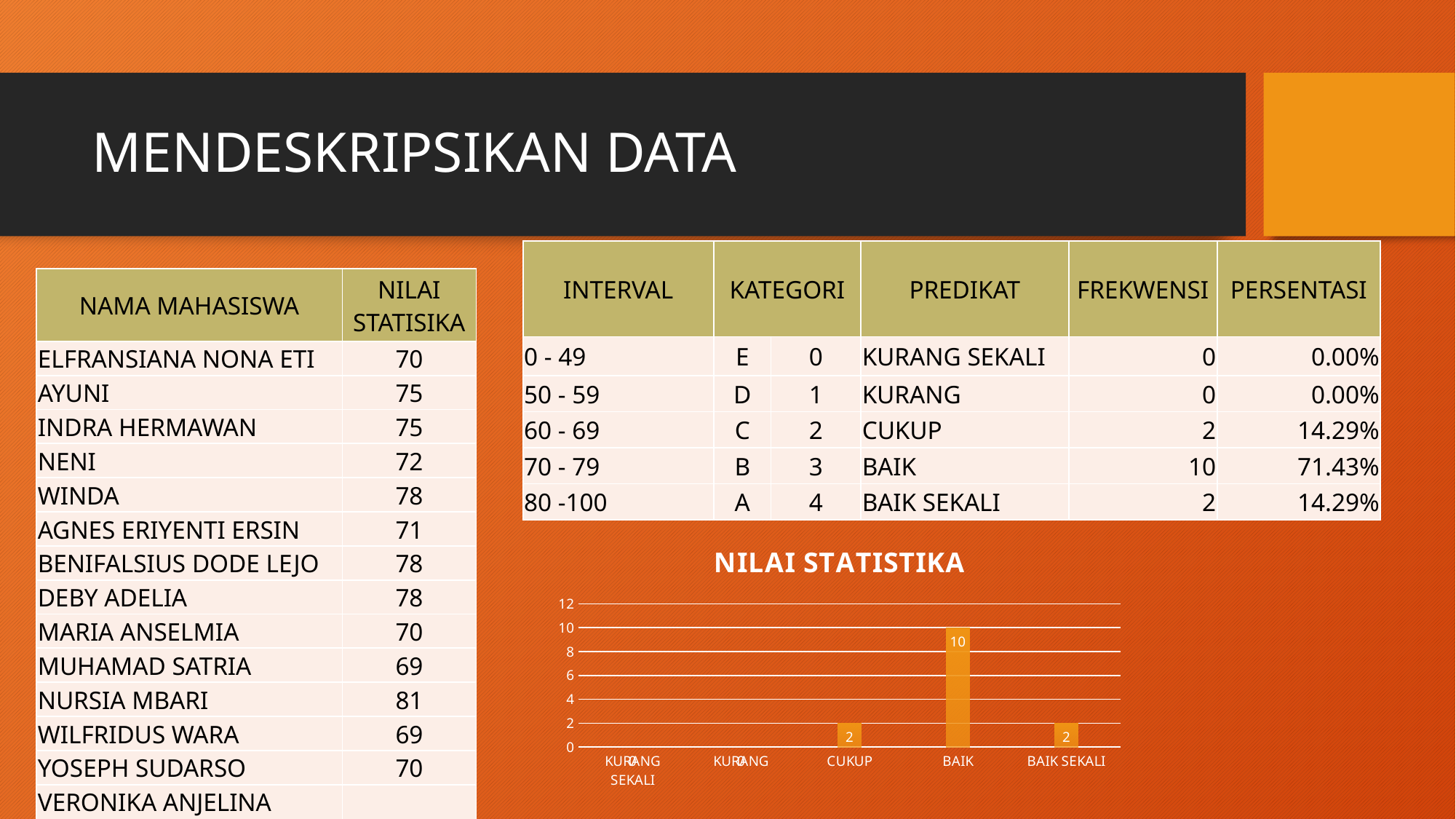
What is the title of the chart on the slide? NILAI STATISTIKA What is the value for KURANG in the NILAI STATISTIKA chart? 0 How many categories are shown on the x axis of the NILAI STATISTIKA chart? 5 What is the highest tick value shown on the y axis of the NILAI STATISTIKA chart? 12 In the NILAI STATISTIKA chart, which is larger: the value for BAIK or the value for BAIK SEKALI? BAIK Is the value for BAIK in the NILAI STATISTIKA chart greater or less than 8? greater What is the value for CUKUP in the NILAI STATISTIKA chart? 2 Which category has the highest value in the NILAI STATISTIKA chart? BAIK What is the difference between the values for BAIK and CUKUP in the NILAI STATISTIKA chart? 8 What is the value for BAIK SEKALI in the NILAI STATISTIKA chart? 2 What kind of chart is the NILAI STATISTIKA chart? bar chart What is the value for BAIK in the NILAI STATISTIKA chart? 10